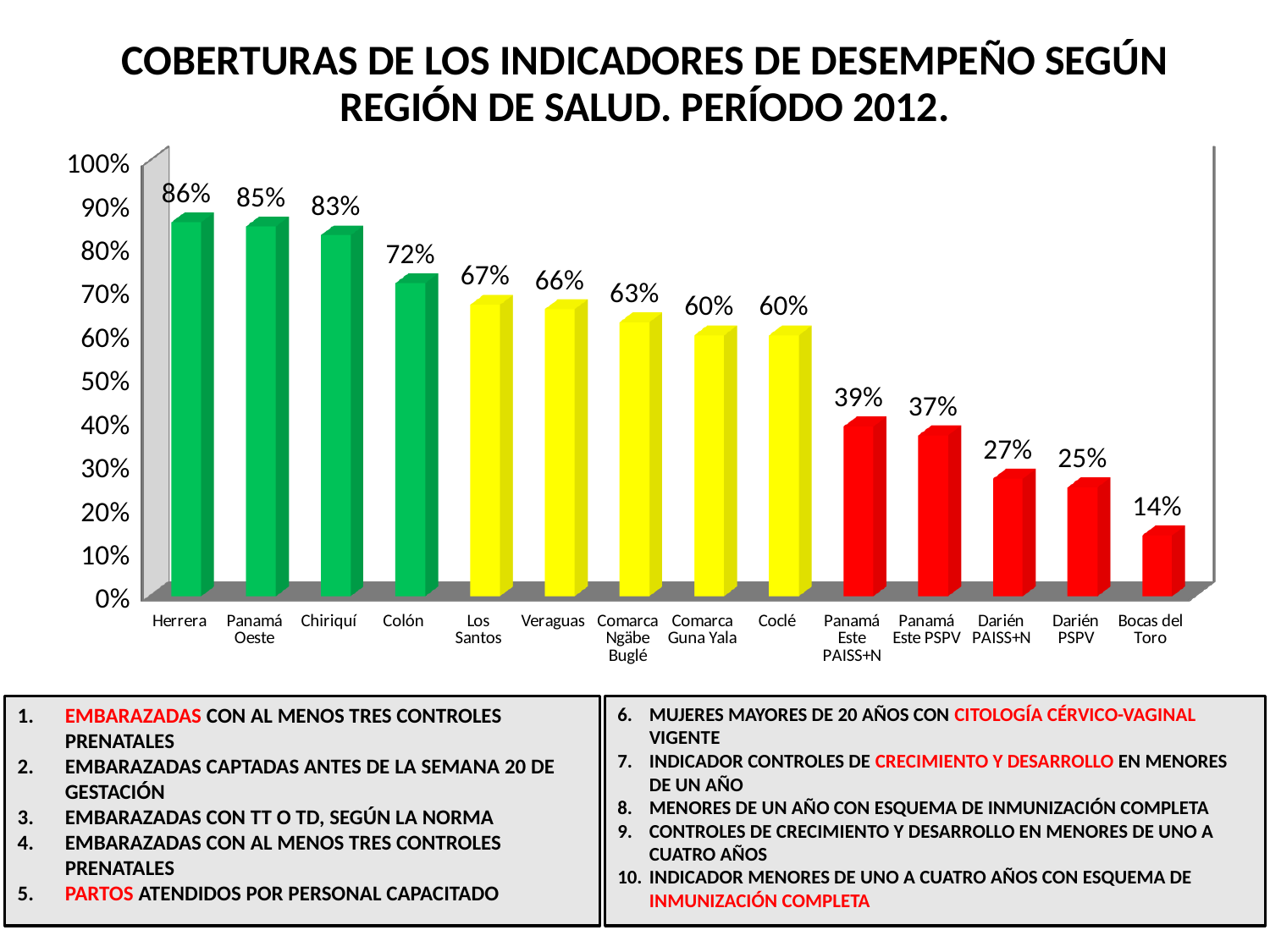
Which region has the highest value? Herrera What colour are the bars for the four regions with the highest values? Green Do the values rise or fall from left to right along the x axis? Fall What is the value for Darién PSPV? 25% Is the value for Chiriquí greater or less than 80%? greater What is the difference between the values for Colón and Los Santos? 5% What kind of chart is shown on the slide? Bar chart What is the value for Comarca Guna Yala? 60% Which region has the lowest value? Bocas del Toro How many regions are shown on the x axis? 14 What is the value for Herrera? 86% Which is larger, the value for Veraguas or the value for Panamá Este PAISS+N? Veraguas